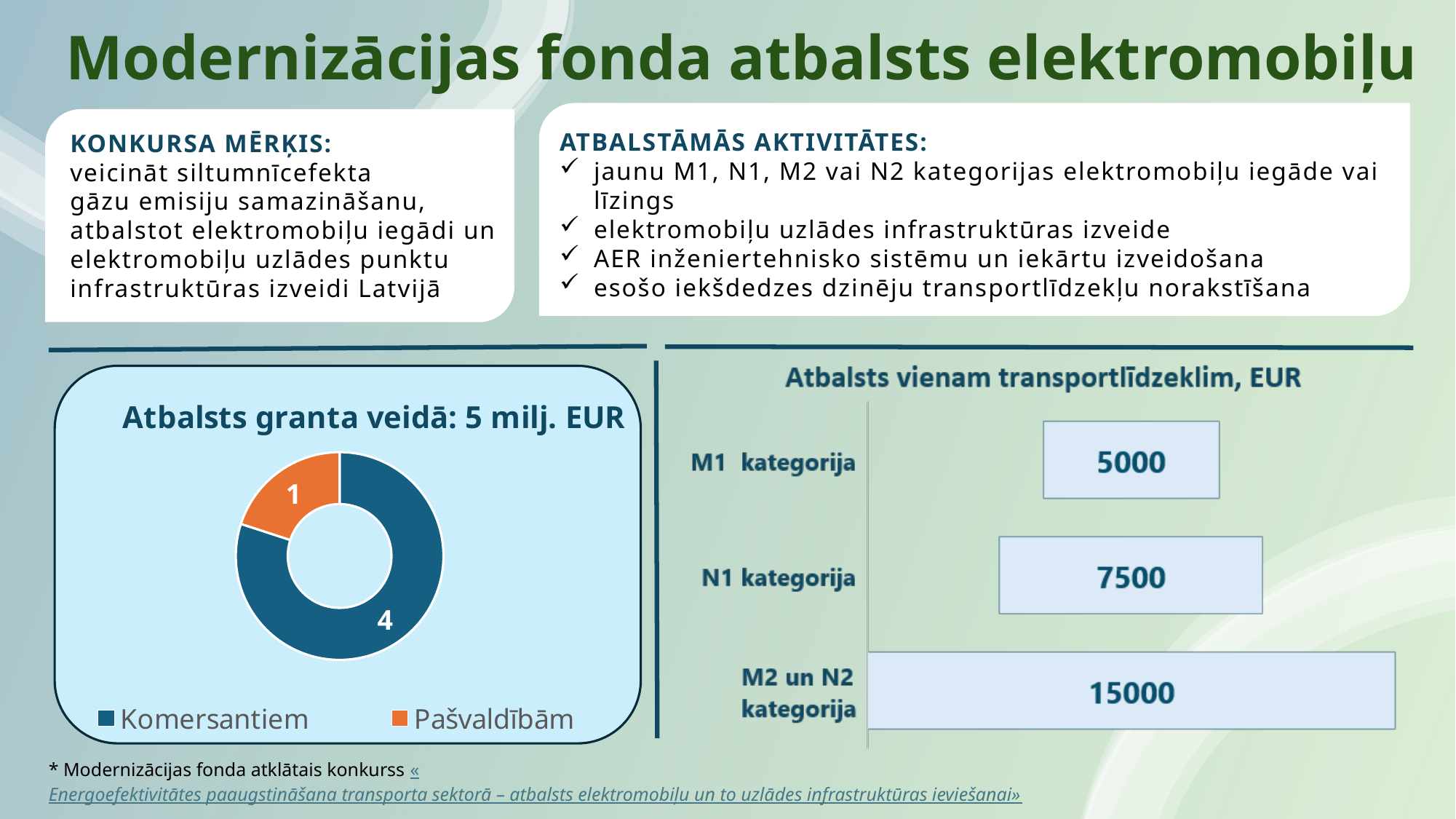
In the chart 'Atbalsts vienam transportlīdzeklim, EUR', what is the value for N1 kategorija? 7500 What kind of chart is 'Atbalsts vienam transportlīdzeklim, EUR'? Bar chart In the chart 'Atbalsts granta veidā: 5 milj. EUR', what is the value for Komersantiem? 4 In the chart 'Atbalsts granta veidā: 5 milj. EUR', what is the value for Pašvaldībām? 1 In the chart 'Atbalsts vienam transportlīdzeklim, EUR', which category has the highest value? M2 un N2 kategorija In the chart 'Atbalsts granta veidā: 5 milj. EUR', what share of the total does Komersantiem represent? 80% In the chart 'Atbalsts vienam transportlīdzeklim, EUR', what is the value for M1 kategorija? 5000 In the chart 'Atbalsts vienam transportlīdzeklim, EUR', what is the difference between the values for M2 un N2 kategorija and N1 kategorija? 7500 In the chart 'Atbalsts granta veidā: 5 milj. EUR', which is larger, Komersantiem or Pašvaldībām? Komersantiem In the chart 'Atbalsts vienam transportlīdzeklim, EUR', which category has the lowest value? M1 kategorija In the chart 'Atbalsts vienam transportlīdzeklim, EUR', how many categories are shown? 3 How many entries does the legend of the chart 'Atbalsts granta veidā: 5 milj. EUR' list? 2